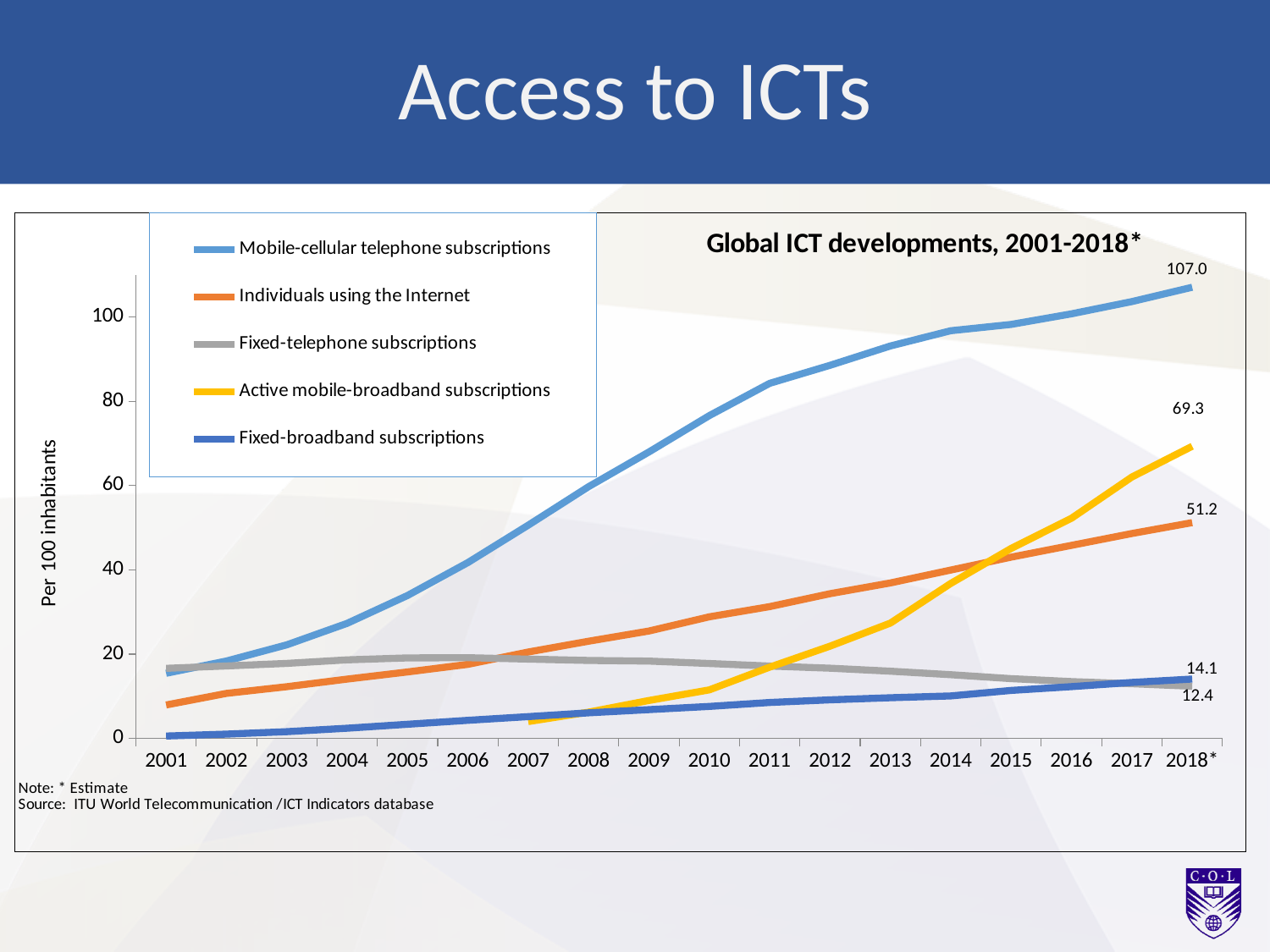
In 2018*, which is larger: Active mobile-broadband subscriptions or Individuals using the Internet? Active mobile-broadband subscriptions Which series has the lowest value in 2018*? Fixed-telephone subscriptions What is the value for Fixed-broadband subscriptions in 2018*? 14.1 Is the value for Mobile-cellular telephone subscriptions in 2010 greater or less than 60? greater What is the value for Active mobile-broadband subscriptions in 2018*? 69.3 What is the difference between Mobile-cellular telephone subscriptions and Individuals using the Internet in 2018*? 55.8 Do the values for Individuals using the Internet rise or fall from 2001 to 2018*? Rise What is the value for Individuals using the Internet in 2018*? 51.2 What is the value for Mobile-cellular telephone subscriptions in 2018*? 107.0 What kind of chart is shown on the slide? Line chart How many series does the legend list? 5 Which series has the highest value in 2018*? Mobile-cellular telephone subscriptions